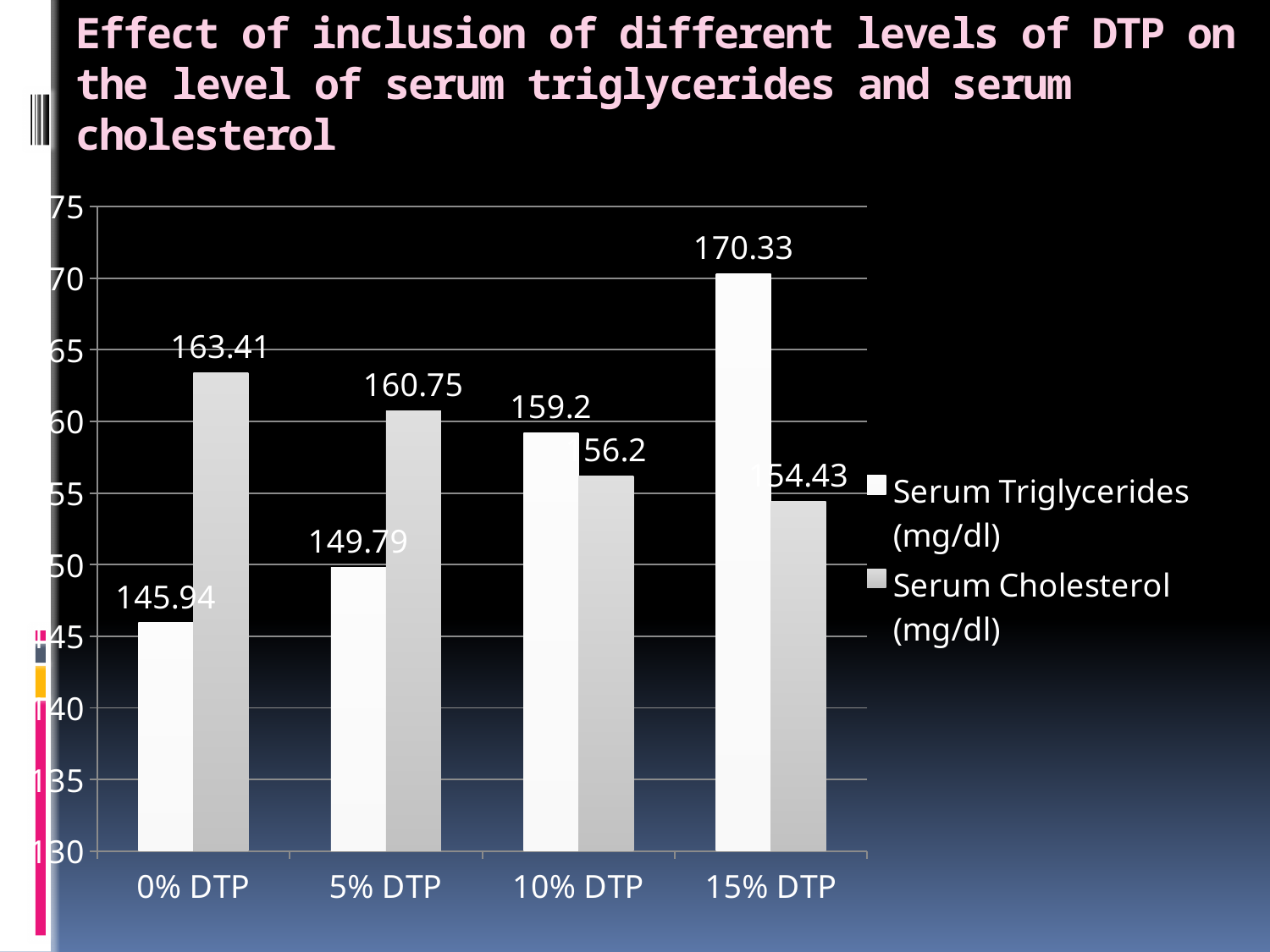
What is the difference between the Serum Triglycerides values at 15% DTP and 0% DTP? 24.39 Do the Serum Triglycerides values rise or fall as the DTP level increases from 0% to 15%? rise Which DTP level has the lowest Serum Cholesterol value? 15% DTP What kind of chart is shown on the slide? bar chart Which DTP level has the highest Serum Triglycerides value? 15% DTP Is the Serum Cholesterol value at 10% DTP greater or less than 155? greater What is the Serum Triglycerides (mg/dl) value at 15% DTP? 170.33 At 0% DTP, which is larger: Serum Triglycerides or Serum Cholesterol? Serum Cholesterol What is the Serum Cholesterol (mg/dl) value at 0% DTP? 163.41 What is the Serum Cholesterol (mg/dl) value at 5% DTP? 160.75 How many series does the legend list? 2 What is the Serum Triglycerides (mg/dl) value at 0% DTP? 145.94